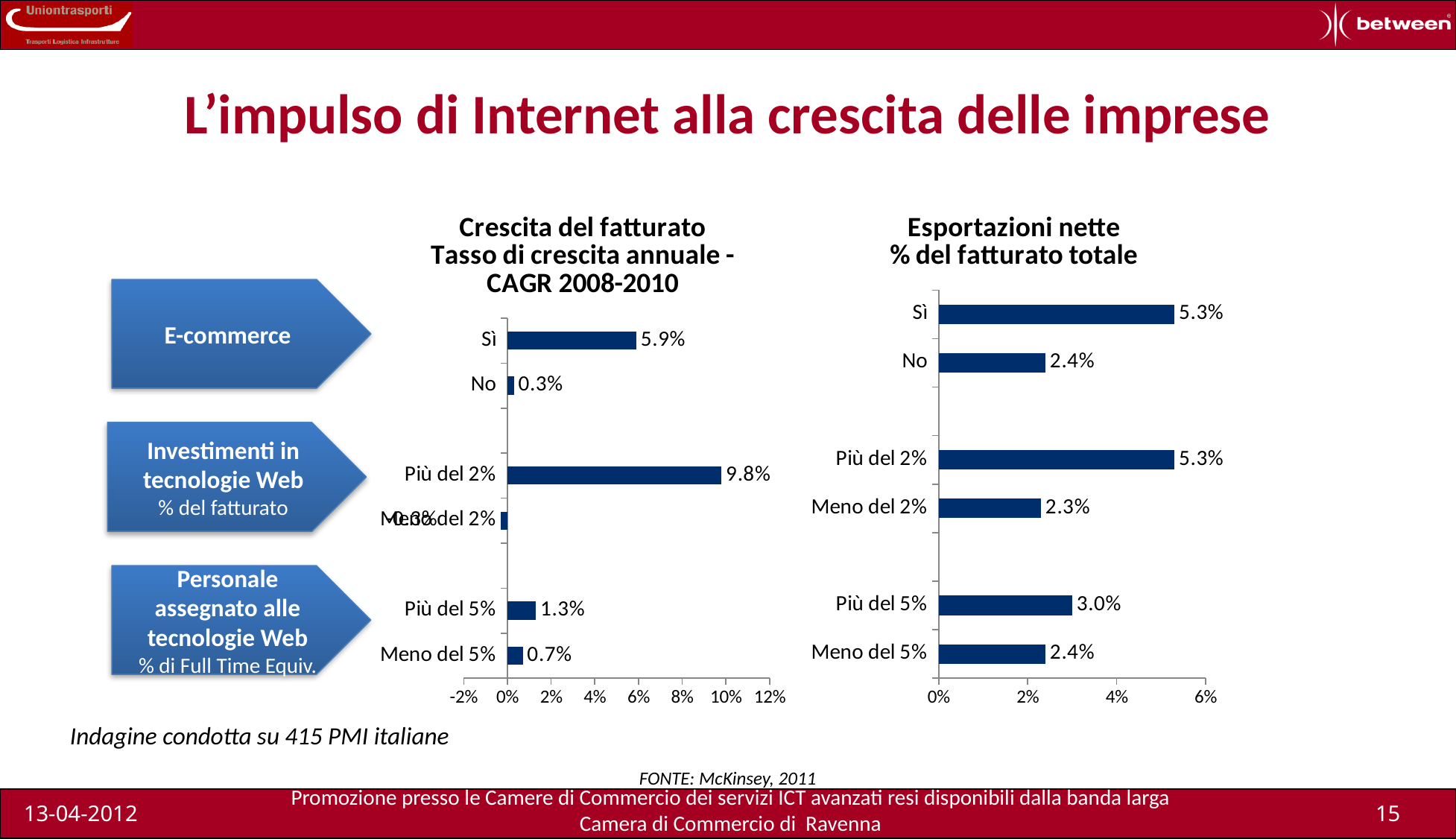
In the 'Esportazioni nette' chart, what is the value for 'Più del 5%'? 3.0% What kind of chart is the 'Esportazioni nette' chart? Bar chart In the 'Esportazioni nette' chart, which is larger, the value for 'Più del 5%' or the value for 'Meno del 5%'? Più del 5% In the 'Esportazioni nette' chart, what is the value for 'No'? 2.4% In the 'Esportazioni nette' chart, what is the difference between the values for 'Più del 2%' and 'Meno del 2%'? 3.0% In the 'Crescita del fatturato' chart, what is the value for 'Più del 2%'? 9.8% In the 'Crescita del fatturato' chart, what is the difference between the values for 'Sì' and 'No'? 5.6% In the 'Crescita del fatturato' chart, what is the value for 'Sì'? 5.9% In the 'Crescita del fatturato' chart, what is the value for 'Meno del 5%'? 0.7% In the 'Crescita del fatturato' chart, which category has the highest value? Più del 2% In the 'Esportazioni nette' chart, which category has the lowest value? Meno del 2% What is the maximum value shown on the x axis of the 'Esportazioni nette' chart? 6%